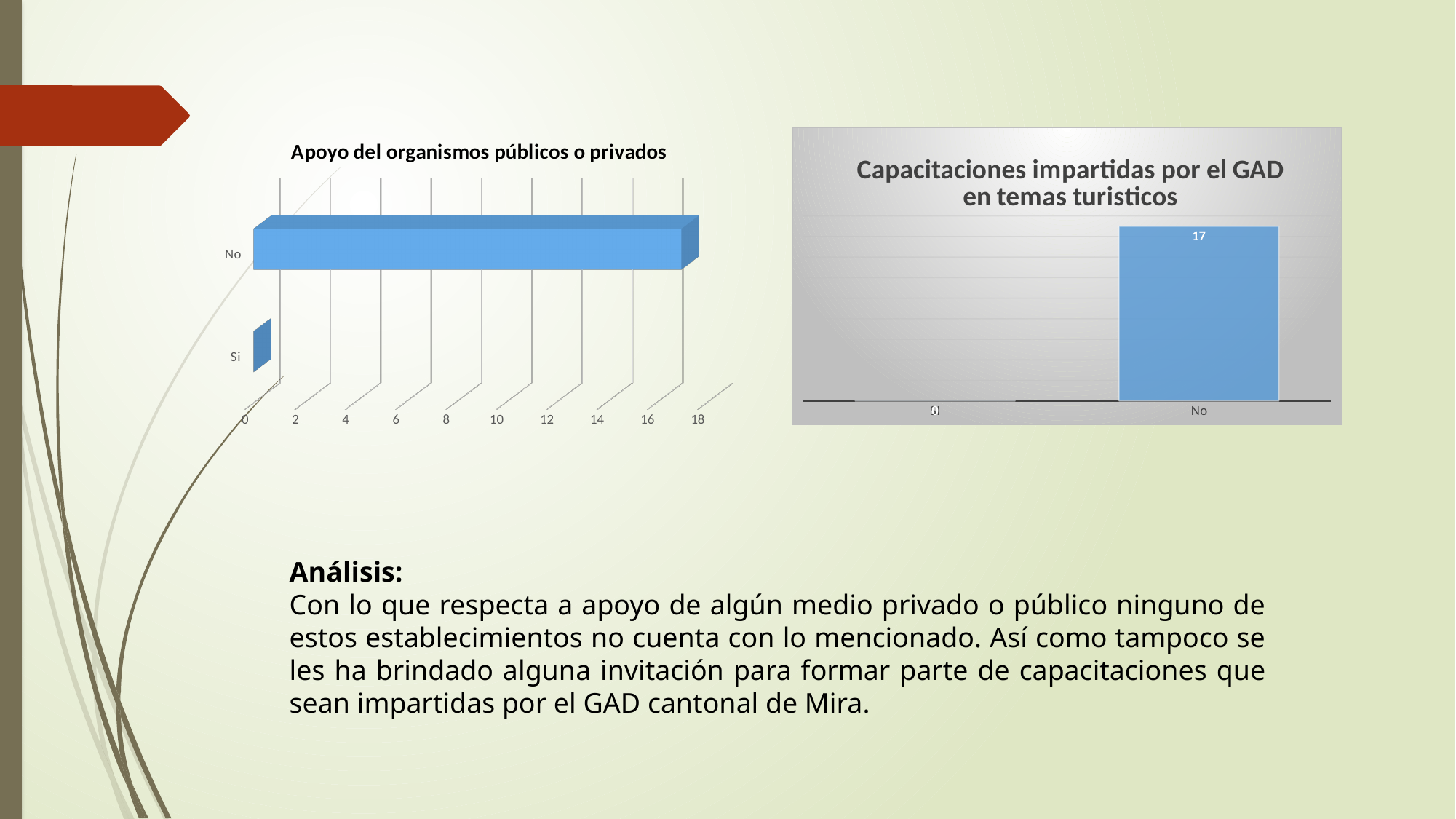
What is the highest tick value shown on the value axis of the chart titled "Apoyo del organismos públicos o privados"? 18 In the chart titled "Apoyo del organismos públicos o privados", is the value for Si greater or less than 4? less What kind of chart is the one titled "Capacitaciones impartidas por el GAD en temas turisticos"? bar chart In the chart titled "Capacitaciones impartidas por el GAD en temas turisticos", which category has the highest value? No What kind of chart is the one titled "Apoyo del organismos públicos o privados"? bar chart How many categories are shown in the chart titled "Apoyo del organismos públicos o privados"? 2 In the chart titled "Apoyo del organismos públicos o privados", is the value for No greater or less than 10? greater In the chart titled "Capacitaciones impartidas por el GAD en temas turisticos", what is the value for No? 17 What is the title of the chart on the right side of the slide? Capacitaciones impartidas por el GAD en temas turisticos In the chart titled "Apoyo del organismos públicos o privados", which category has the highest value? No In the chart titled "Apoyo del organismos públicos o privados", which is larger, the value for No or the value for Si? No In the chart titled "Apoyo del organismos públicos o privados", which category has the lowest value? Si